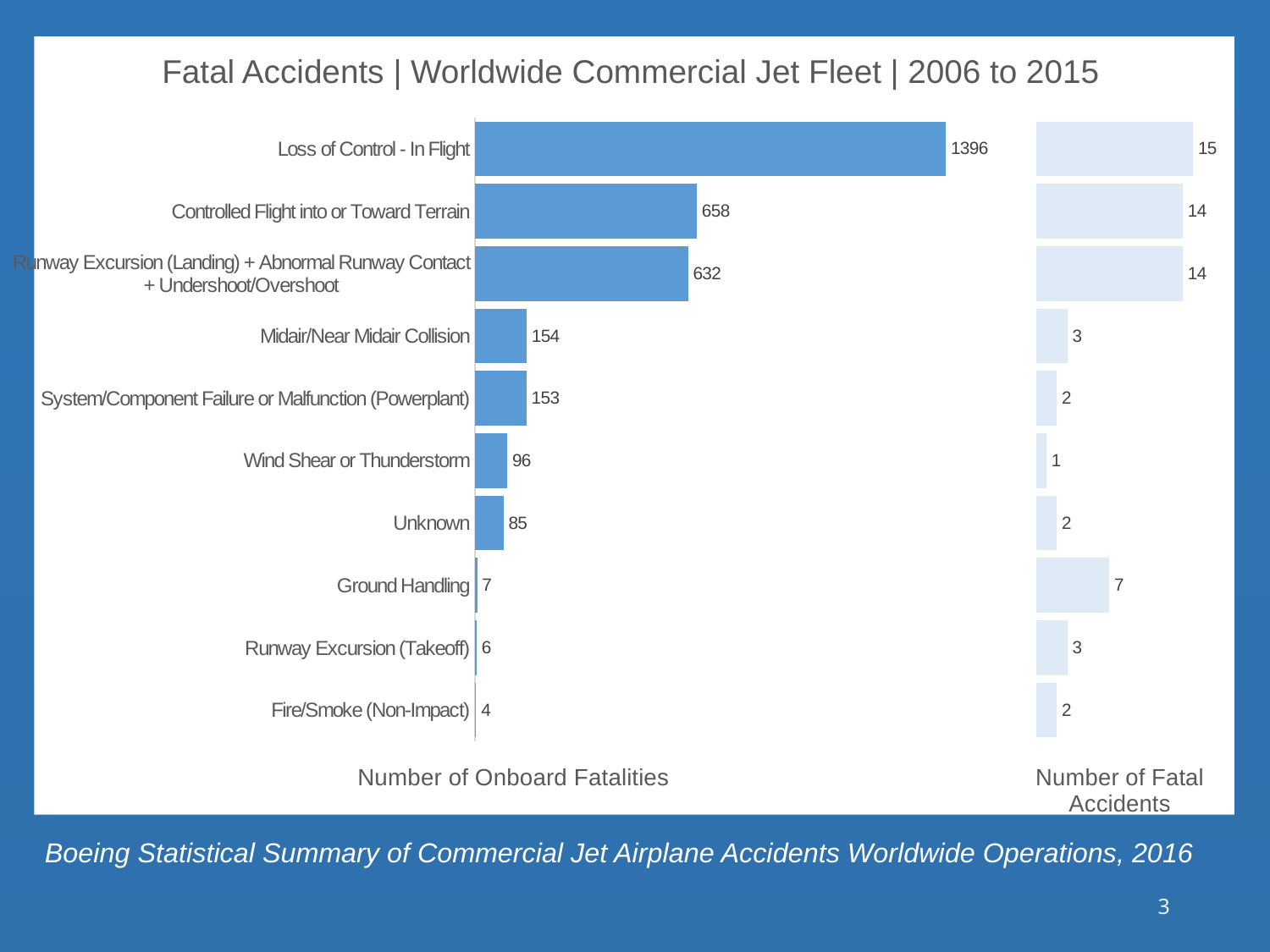
In the Number of Onboard Fatalities chart, what is the difference between Controlled Flight into or Toward Terrain and Runway Excursion (Landing) + Abnormal Runway Contact + Undershoot/Overshoot? 26 In the Number of Onboard Fatalities chart, what is the value for Loss of Control - In Flight? 1396 In the Number of Fatal Accidents chart, which category has the highest value? Loss of Control - In Flight In the Number of Onboard Fatalities chart, which category has the lowest value? Fire/Smoke (Non-Impact) In the Number of Fatal Accidents chart, what is the value for Ground Handling? 7 In the Number of Fatal Accidents chart, what is the difference between Loss of Control - In Flight and Ground Handling? 8 What kind of chart is the Number of Onboard Fatalities chart? Bar chart How many categories are shown in the Number of Onboard Fatalities chart? 10 In the Number of Fatal Accidents chart, which is larger: Ground Handling or Runway Excursion (Takeoff)? Ground Handling What is the title of the slide containing the charts? Fatal Accidents | Worldwide Commercial Jet Fleet | 2006 to 2015 In the Number of Onboard Fatalities chart, which is larger: Midair/Near Midair Collision or Unknown? Midair/Near Midair Collision In the Number of Onboard Fatalities chart, what is the value for Wind Shear or Thunderstorm? 96